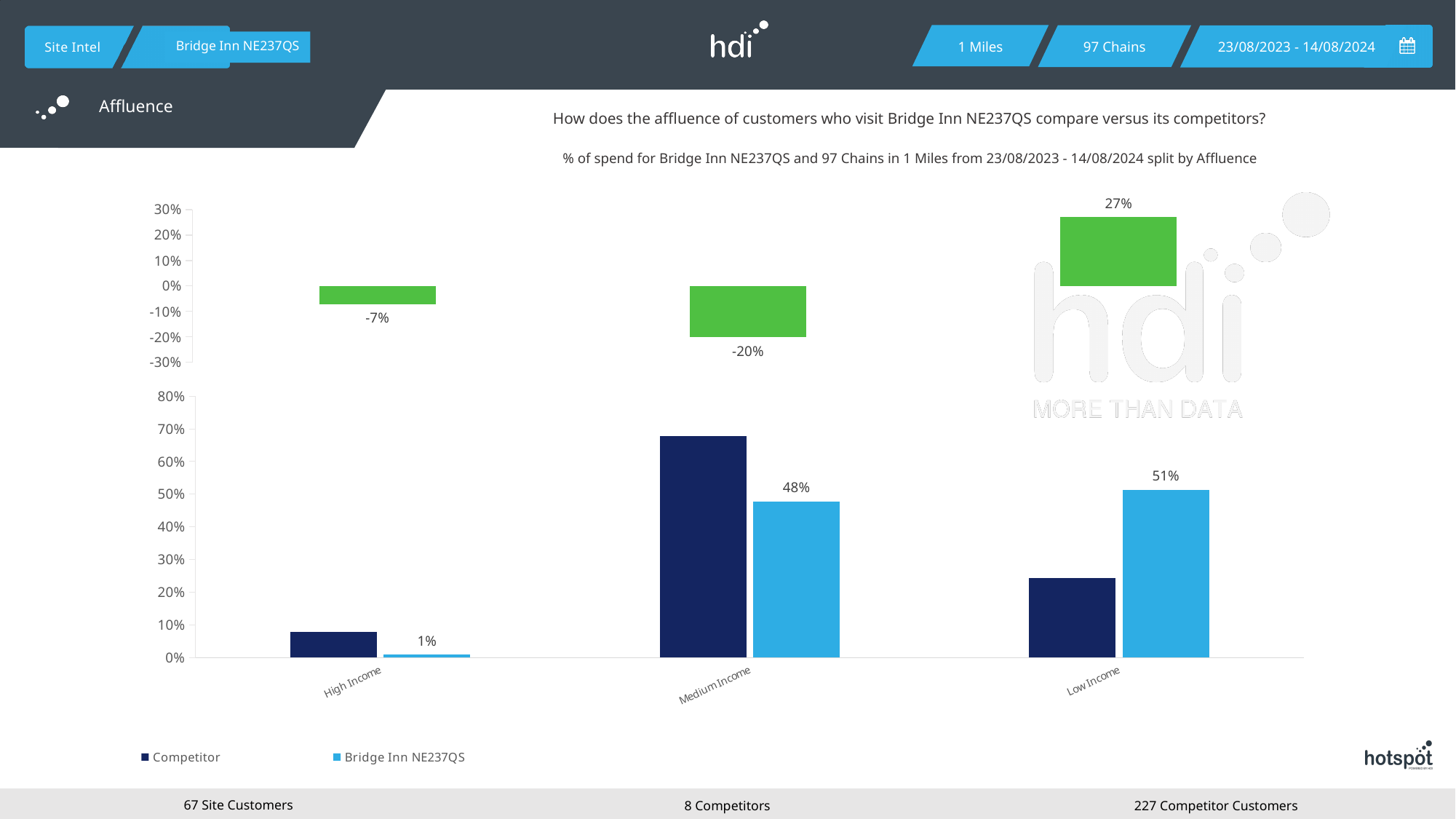
In the top chart, what is the value shown for Low Income? 27% How many series does the legend of the bottom chart list? 2 In the bottom chart, which is larger for Medium Income: Competitor or Bridge Inn NE237QS? Competitor In the top chart, what is the value shown for Medium Income? -20% In the bottom chart, is the Competitor value for Medium Income greater or less than 60%? greater In the bottom chart, what is the value for Bridge Inn NE237QS in the High Income category? 1% In the bottom chart, what is the difference between the Bridge Inn NE237QS values for Low Income and Medium Income? 3% In the bottom chart, what is the value for Bridge Inn NE237QS in the Medium Income category? 48% In the bottom chart, is the Competitor value for Low Income greater or less than 30%? less In the top chart, which category has the lowest value? Medium Income In the bottom chart, which category has the highest value for Bridge Inn NE237QS? Low Income In the bottom chart, what is the value for Bridge Inn NE237QS in the Low Income category? 51%